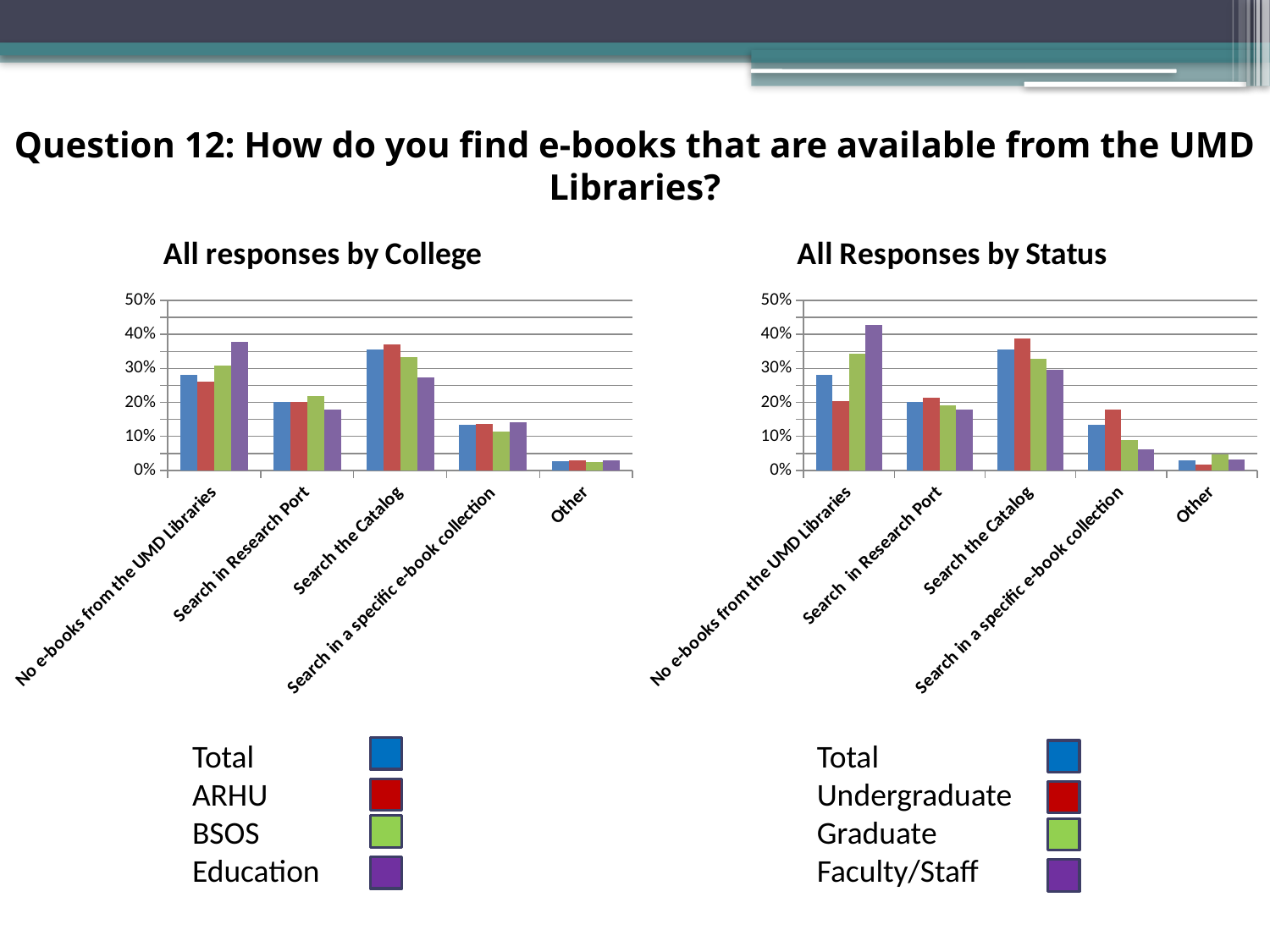
In the "All Responses by Status" chart, is the Faculty/Staff value for "Search in a specific e-book collection" greater or less than 10%? less What kind of chart is "All responses by College"? Bar chart In the "All responses by College" chart, which college has the highest bar for "No e-books from the UMD Libraries"? Education In the "All responses by College" chart, is the Education value for "Search the Catalog" greater or less than 30%? less Which series are listed in the legend of the "All Responses by Status" chart? Total, Undergraduate, Graduate, Faculty/Staff How many response categories are shown along the x axis of the "All Responses by Status" chart? 5 In the "All Responses by Status" chart, is the Faculty/Staff value for "No e-books from the UMD Libraries" greater or less than 40%? greater How many series does the legend of the "All responses by College" chart list? 4 In the "All Responses by Status" chart, which status group has the highest bar for "No e-books from the UMD Libraries"? Faculty/Staff In the "All Responses by Status" chart, which status group has the highest bar for "Search in a specific e-book collection"? Undergraduate In the "All responses by College" chart, for "Search the Catalog", which is larger: the ARHU bar or the Education bar? ARHU In the "All Responses by Status" chart, which status group has the lowest bar for "No e-books from the UMD Libraries"? Undergraduate